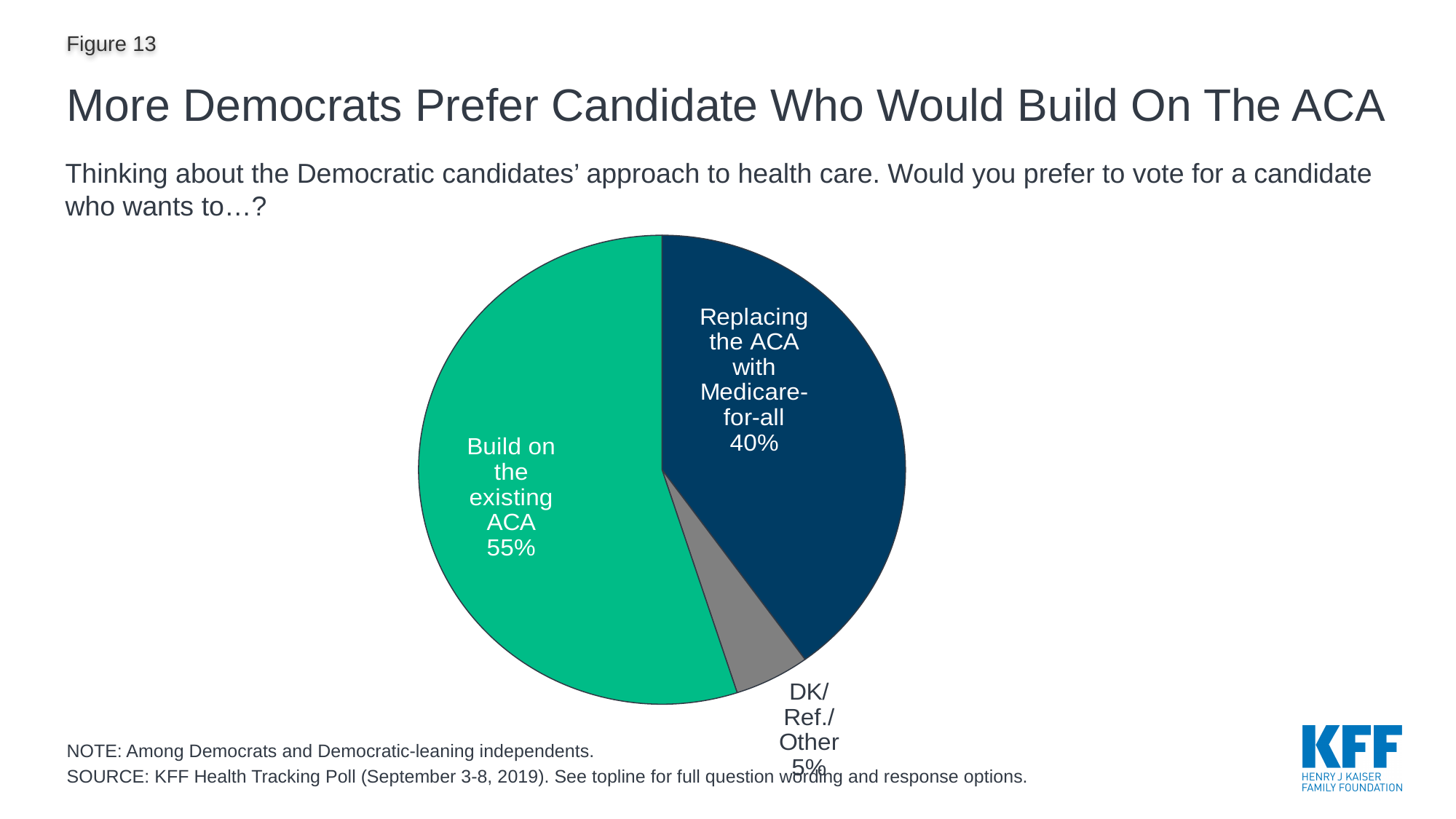
What percentage is shown for the DK/Ref./Other slice? 5% Which is larger: the share for 'Build on the existing ACA' or the share for 'Replacing the ACA with Medicare-for-all'? Build on the existing ACA Which response option has the largest share of the pie? Build on the existing ACA What is the title of the slide? More Democrats Prefer Candidate Who Would Build On The ACA What share of Democrats prefer a candidate who wants to build on the existing ACA? 55% Which response option has the smallest share of the pie? DK/Ref./Other What kind of chart is shown on the slide? Pie chart What is the difference in percentage points between 'Build on the existing ACA' and 'Replacing the ACA with Medicare-for-all'? 15 percentage points How many slices does the pie chart have? 3 What is the combined share of 'Build on the existing ACA' and 'Replacing the ACA with Medicare-for-all'? 95% What colour is the 'Build on the existing ACA' slice? Green What share of Democrats prefer a candidate who wants to replace the ACA with Medicare-for-all? 40%